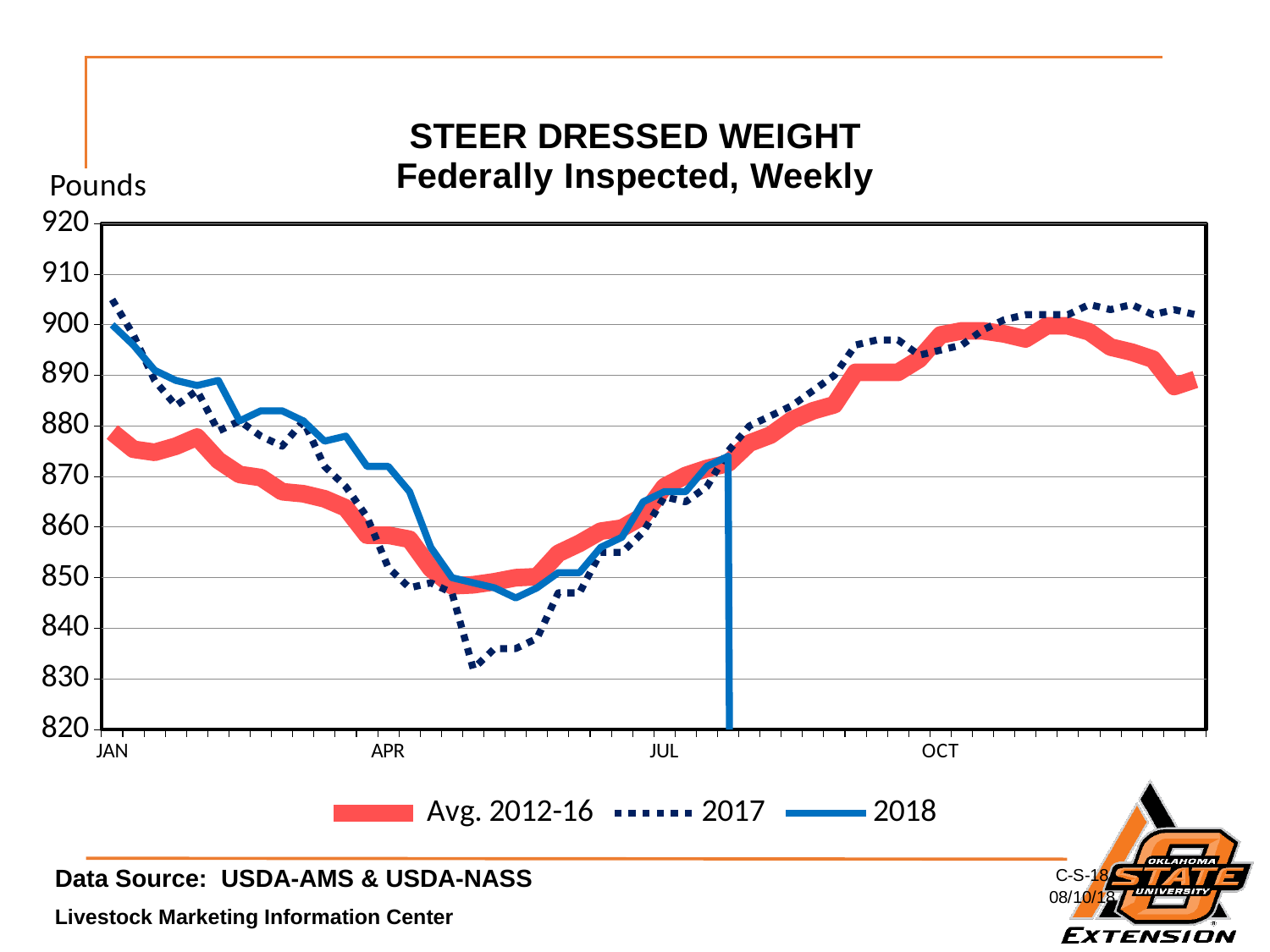
Is the lowest value of the 2018 series greater or less than 850? less Is the value for Avg. 2012-16 at the start of January greater or less than 870? greater What kind of chart is shown on the slide? line chart Is the value for 2017 in October greater or less than 890? greater At the start of January, which is higher: 2017 or Avg. 2012-16? 2017 What is the title of the chart? STEER DRESSED WEIGHT Federally Inspected, Weekly Do the values for Avg. 2012-16 rise or fall from JAN to APR? fall How many series does the legend list? 3 What unit is shown on the vertical axis label? Pounds